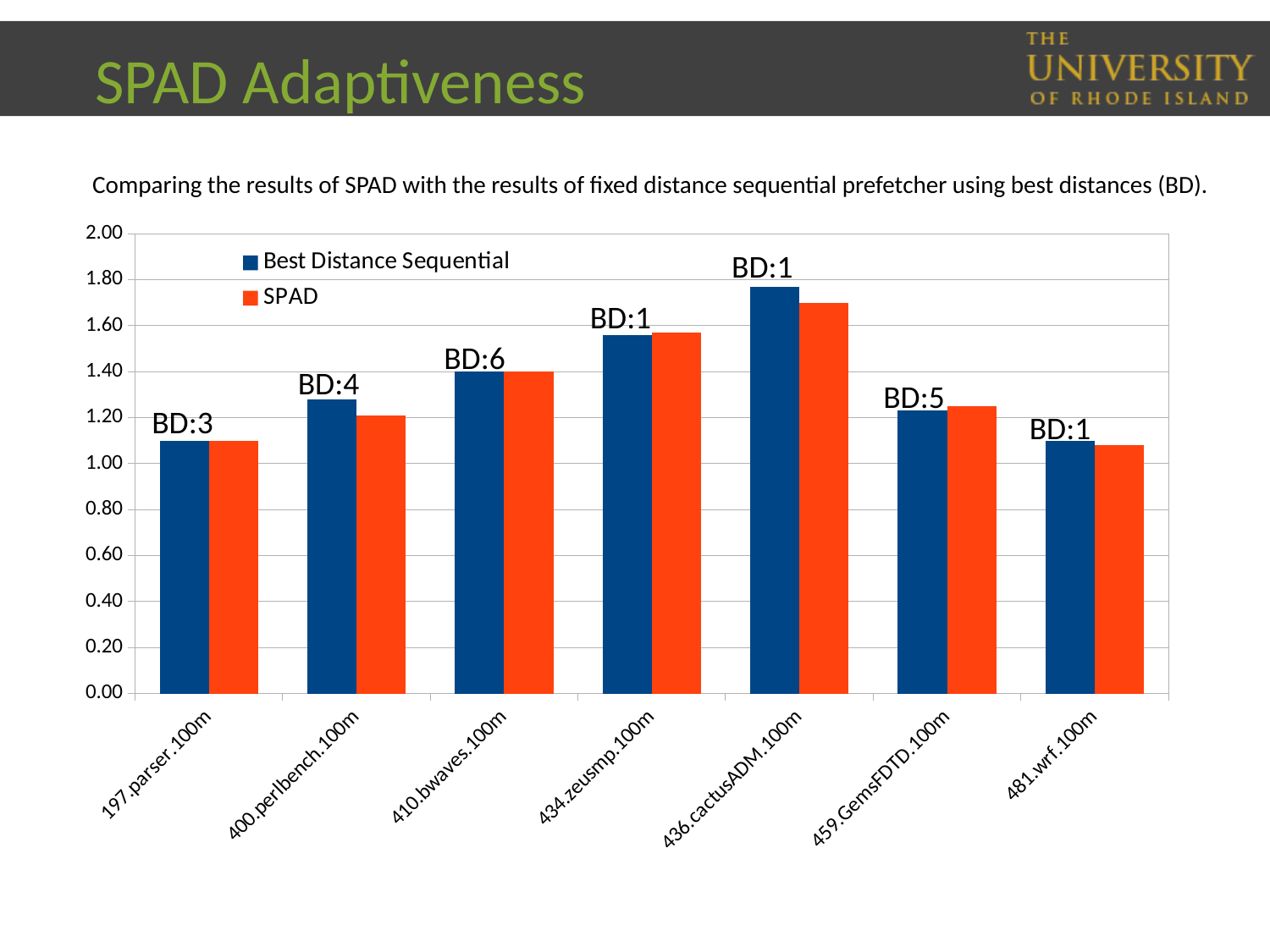
Which benchmark has the highest Best Distance Sequential value? 436.cactusADM.100m For 400.perlbench.100m, which is larger: the Best Distance Sequential value or the SPAD value? Best Distance Sequential How many series does the chart legend list? 2 Is the Best Distance Sequential value for 436.cactusADM.100m greater or less than 1.60? greater How many benchmark categories are plotted along the x axis? 7 Is the SPAD value for 197.parser.100m greater or less than 1.20? less What kind of chart is shown on the slide? bar chart Is the SPAD value for 481.wrf.100m greater or less than 1.20? less Which benchmark has the highest SPAD value? 436.cactusADM.100m Which series is drawn in orange in the chart? SPAD What BD annotation is shown above the bars for 410.bwaves.100m? BD:6